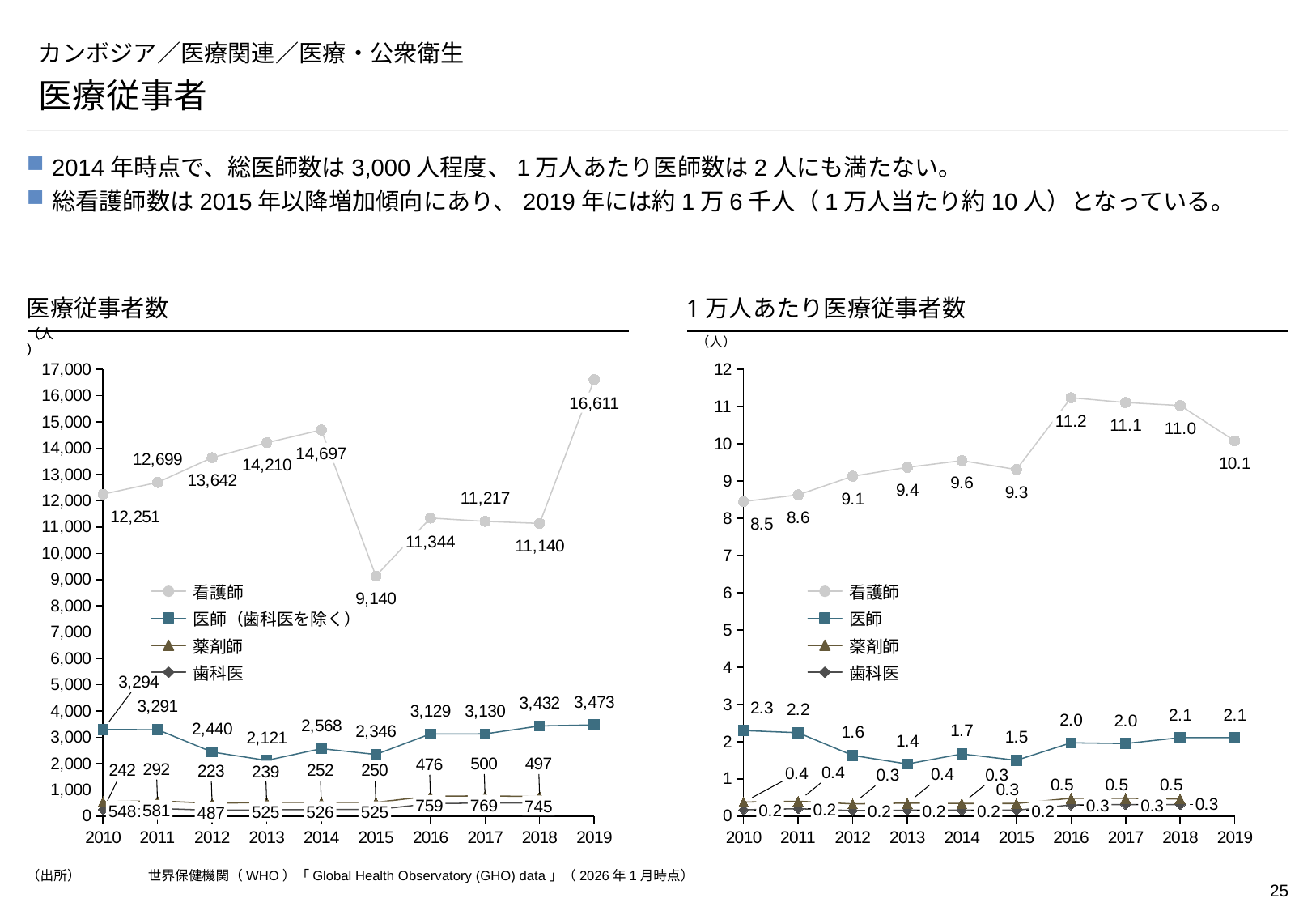
In the 1万人あたり医療従事者数 chart on the right, what is the value for 看護師 in 2016? 11.2 In the 医療従事者数 chart on the left, what is the difference between the 医師（歯科医を除く） values for 2019 and 2013? 1,352 In the 1万人あたり医療従事者数 chart on the right, how many years are shown on the x axis? 10 In the 医療従事者数 chart on the left, how many series does the legend list? 4 What kind of chart is the 医療従事者数 chart on the left? Line chart In the 医療従事者数 chart on the left, what is the value for 看護師 in 2019? 16,611 In the 医療従事者数 chart on the left, in which year is the 看護師 value lowest? 2015 In the 1万人あたり医療従事者数 chart on the right, is the 看護師 value larger in 2014 or in 2015? 2014 In the 医療従事者数 chart on the left, what is the value for 医師（歯科医を除く） in 2013? 2,121 In the 1万人あたり医療従事者数 chart on the right, in which year is the 看護師 value highest? 2016 In the 1万人あたり医療従事者数 chart on the right, in which year is the 医師 value lowest? 2013 In the 医療従事者数 chart on the left, what is the difference between the 看護師 values for 2019 and 2018? 5,471